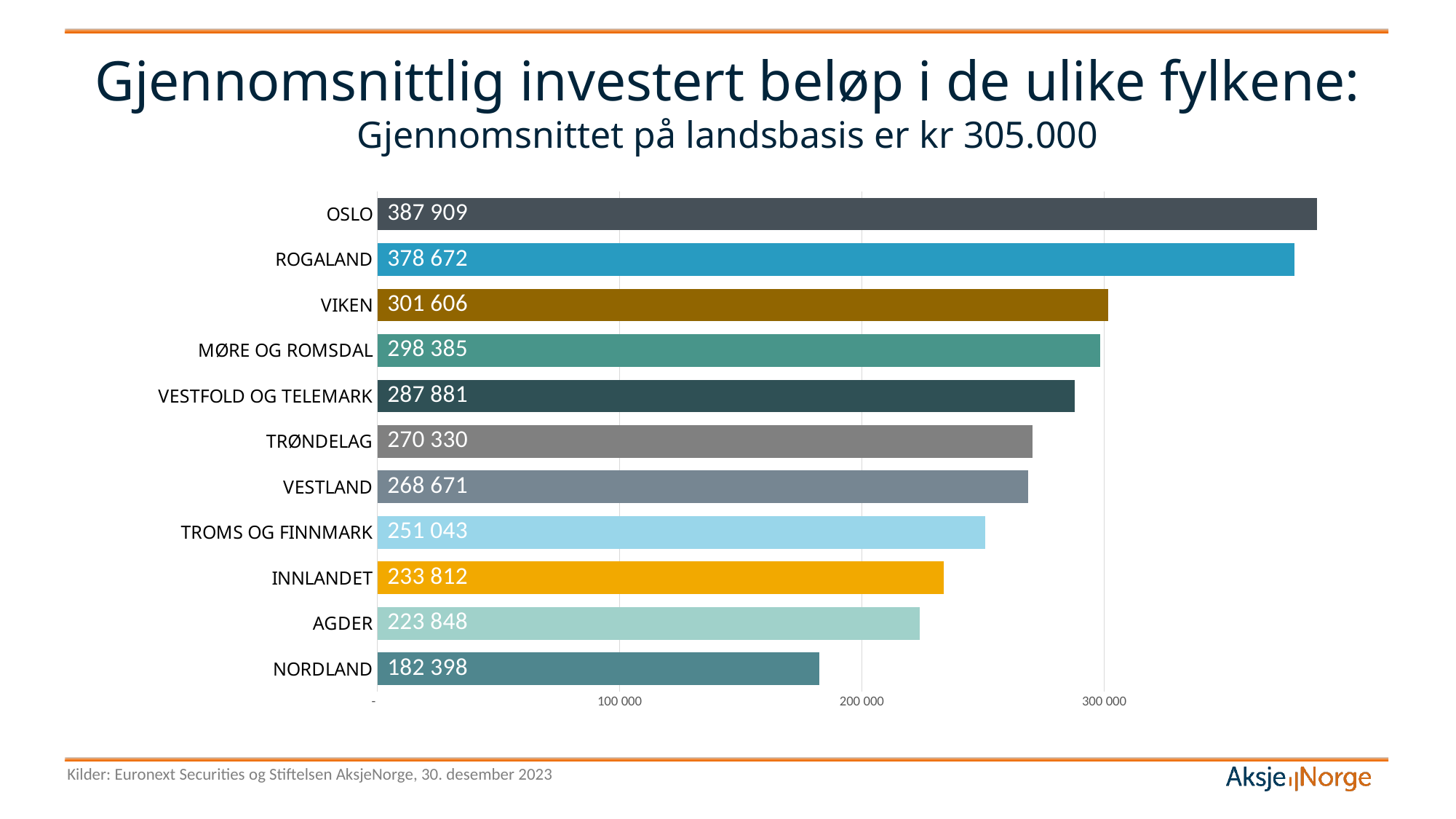
What is the difference between the values for Oslo and Rogaland? 9 237 What is the national average stated in the slide subtitle? kr 305.000 Which has a larger value, Innlandet or Agder? Innlandet Which county has the highest average invested amount? Oslo What is the average invested amount for Oslo? 387 909 How many counties are shown in the chart? 11 Is the value for Vestfold og Telemark greater or less than 300 000? less Which county has the lowest average invested amount? Nordland What is the value shown for Nordland? 182 398 What is the value shown for Troms og Finnmark? 251 043 What is the difference between the values for Viken and Nordland? 119 208 What kind of chart is shown on the slide? bar chart